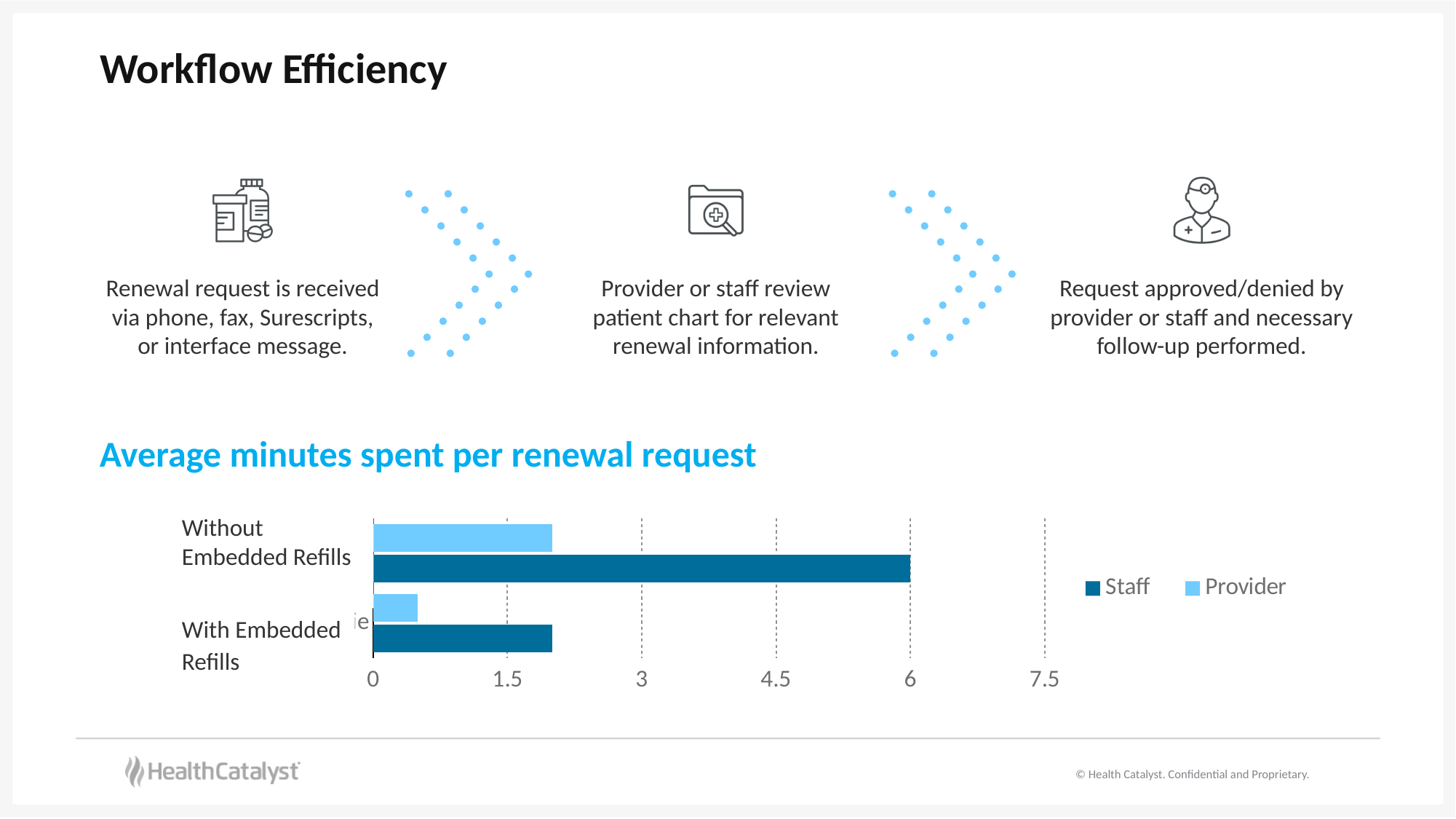
For With Embedded Refills, which is larger: Staff or Provider? Staff Which bar in the chart has the highest value? Staff, Without Embedded Refills For Without Embedded Refills, which is larger: Staff or Provider? Staff How many series does the chart legend list? 2 How many categories are shown on the chart? 2 Is the Staff value for With Embedded Refills greater or less than 3? less Which bar in the chart has the lowest value? Provider, With Embedded Refills Is the Provider value for Without Embedded Refills greater or less than 1.5? greater What kind of chart is shown on the slide? bar chart What is the Staff value for Without Embedded Refills? 6 Is the Provider value for With Embedded Refills greater or less than 1.5? less What is the title of the chart on the slide? Average minutes spent per renewal request